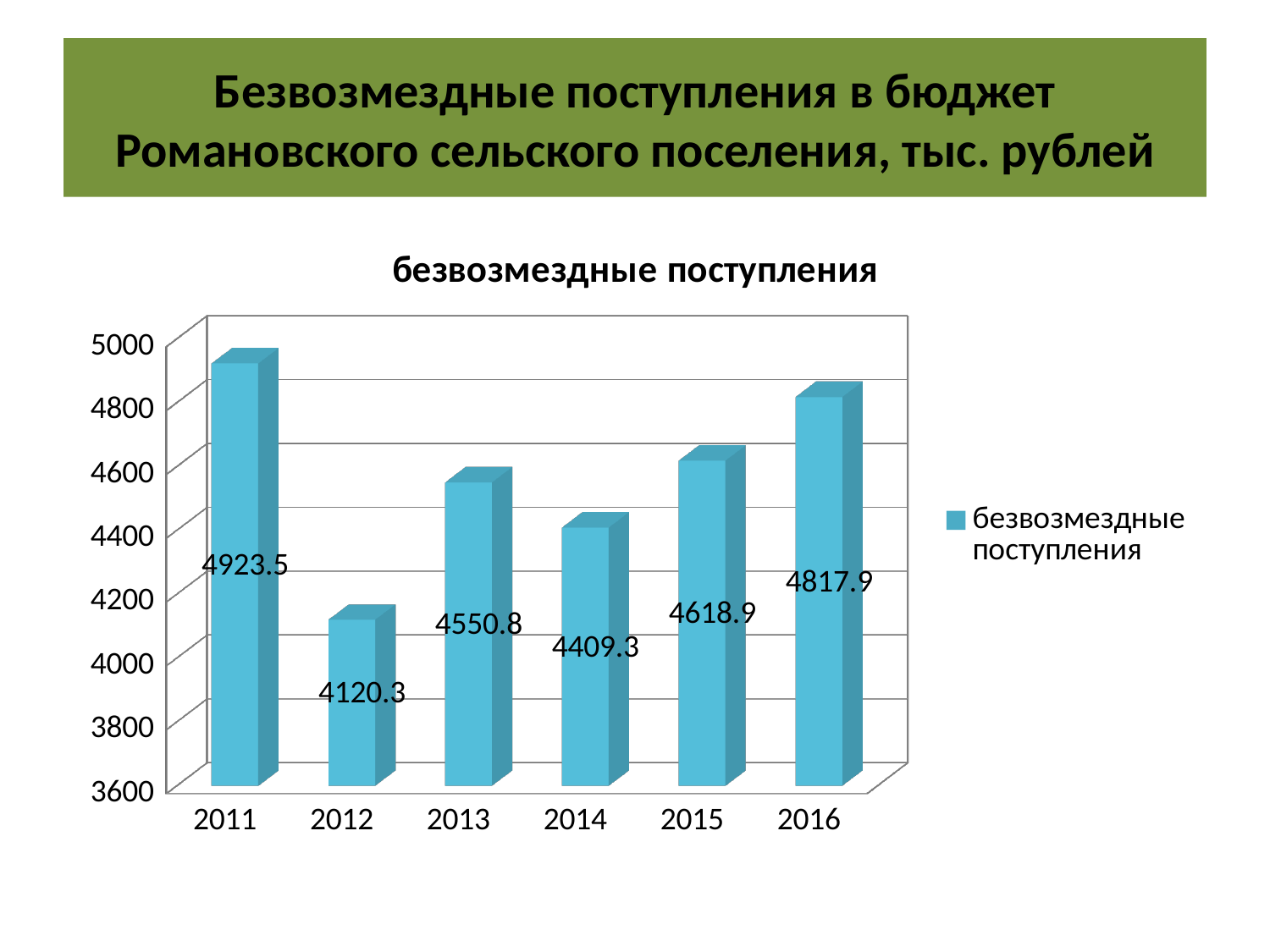
Which year has the lowest value? 2012 What kind of chart is this? bar chart Which is larger, the value for 2013 or the value for 2014? 2013 What is the value for 2014? 4409.3 What is the value for 2011? 4923.5 How many years are shown on the x axis? 6 What is the difference between the values for 2011 and 2012? 803.2 Which year has the highest value? 2011 What is the title of the chart? безвозмездные поступления Is the value for 2015 greater or less than 4400? greater What is the value for 2016? 4817.9 What is the difference between the values for 2016 and 2015? 199